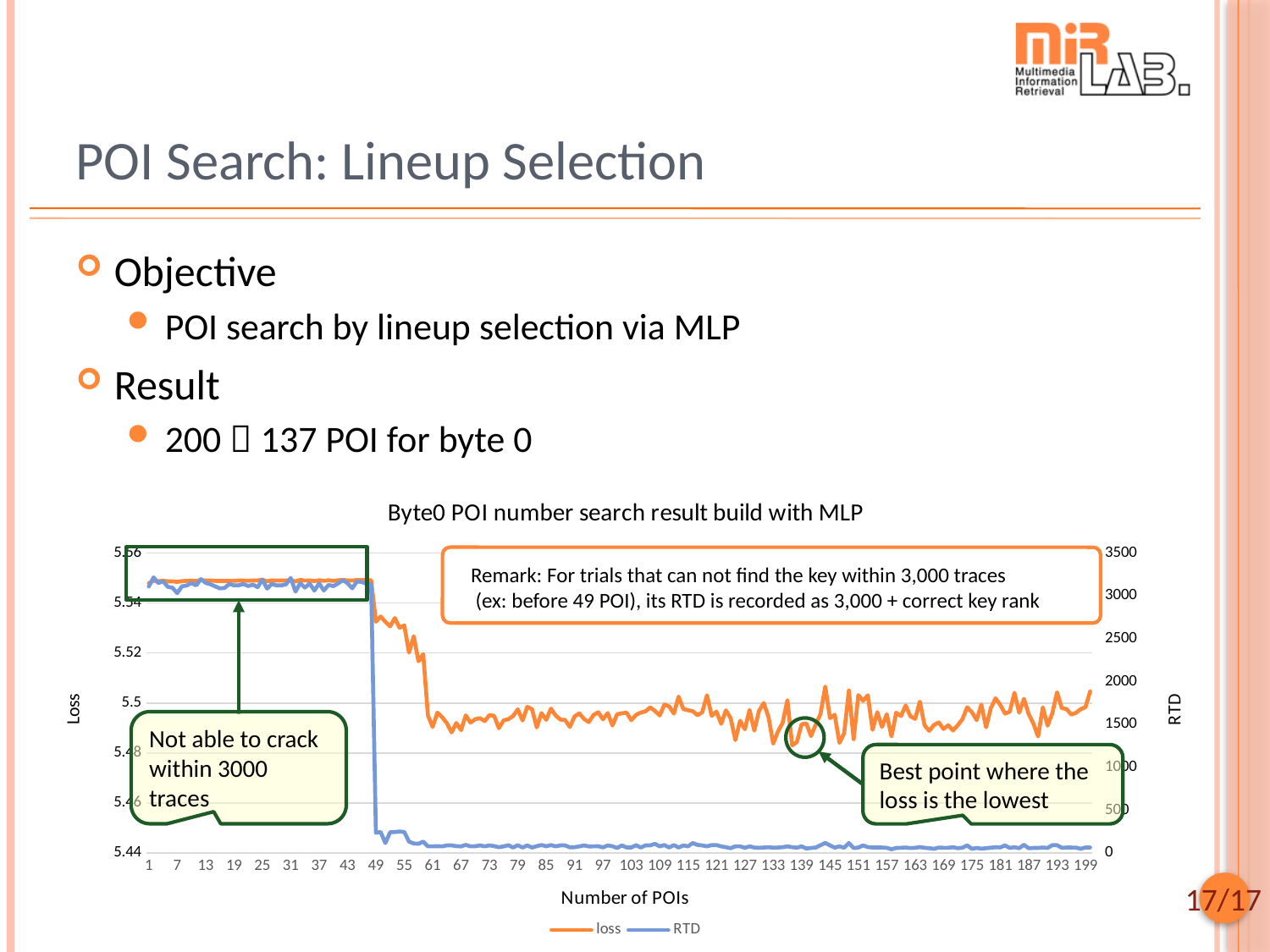
Is the RTD value at 25 POIs greater or less than 2500? greater Which is larger, the loss at 25 POIs or the loss at 100 POIs? 25 POIs Which is larger, the RTD at 10 POIs or the RTD at 150 POIs? 10 POIs Does the RTD series overall rise or fall as the number of POIs increases? fall How many series does the chart legend list? 2 Is the RTD value at 100 POIs greater or less than 500? less Is the loss value at 139 POIs greater or less than 5.5? less What kind of chart is shown on the slide? line chart What is the label of the x axis of the chart? Number of POIs What is the title of the chart? Byte0 POI number search result build with MLP